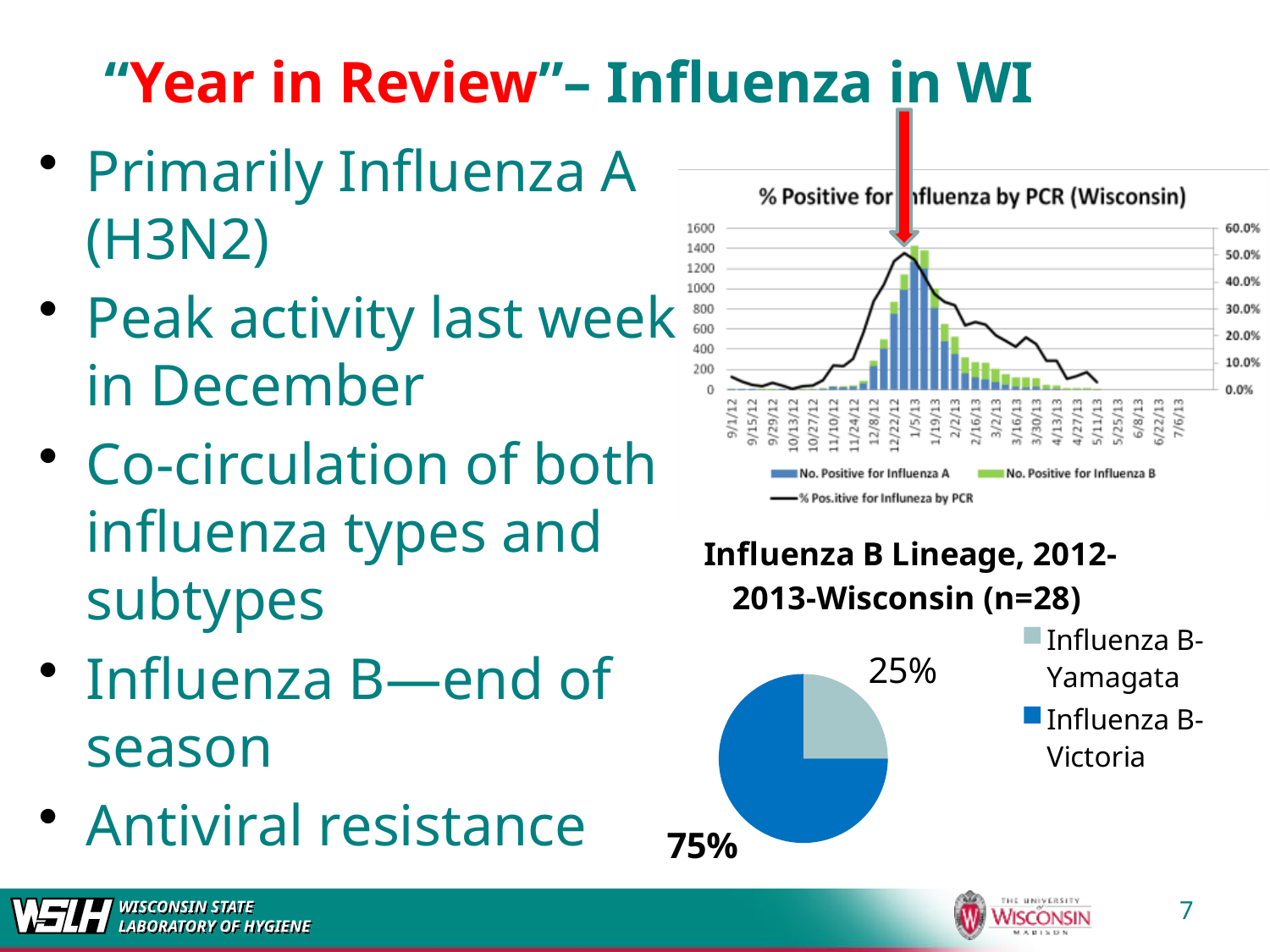
In the Influenza B Lineage pie chart, which lineage has the smallest slice? Influenza B-Yamagata In the Influenza B Lineage pie chart, which lineage has the largest slice? Influenza B-Victoria What type of chart is the Influenza B Lineage chart? Pie chart In the chart titled "% Positive for Influenza by PCR (Wisconsin)", is the number positive for Influenza A at 1/5/13 greater or less than 800? greater In the chart titled "% Positive for Influenza by PCR (Wisconsin)", is the number positive for Influenza A at 9/1/12 greater or less than 200? less In the pie chart titled "Influenza B Lineage, 2012-2013-Wisconsin (n=28)", what share is Influenza B-Victoria? 75% In the Influenza B Lineage pie chart, what sample size is given in the title? n=28 In the chart titled "% Positive for Influenza by PCR (Wisconsin)", how many series does the legend list? 3 In the Influenza B Lineage pie chart, what is the difference in percentage points between the Victoria and Yamagata slices? 50 In the chart titled "% Positive for Influenza by PCR (Wisconsin)", which series is drawn as a black line? % Positive for Influenza by PCR In the Influenza B Lineage pie chart, how many slices are shown? 2 In the pie chart titled "Influenza B Lineage, 2012-2013-Wisconsin (n=28)", what share is Influenza B-Yamagata? 25%